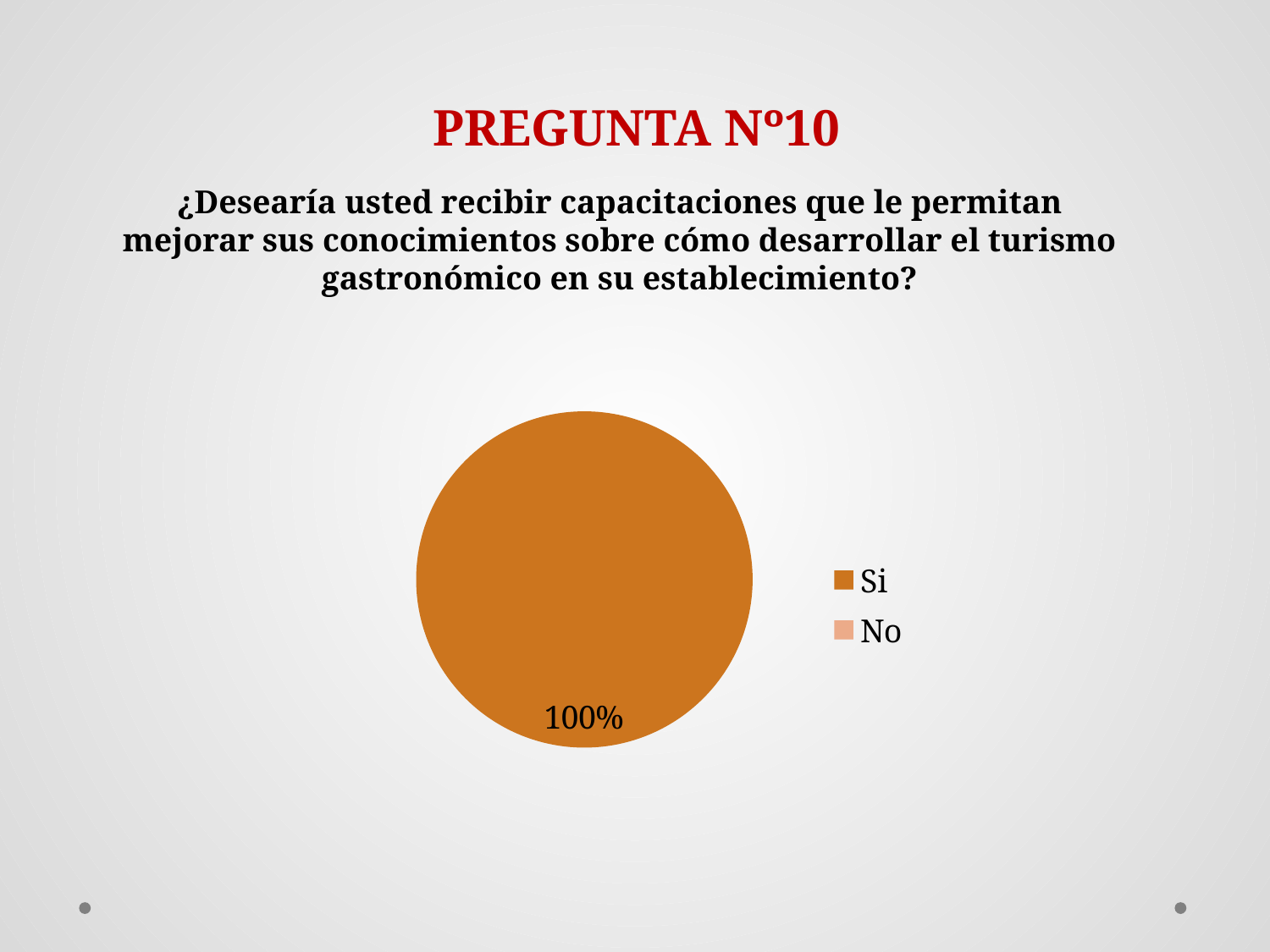
Is the share for "Si" greater or less than 50%? greater What are the two legend entries of the pie chart? Si and No What colour is the "Si" slice of the pie chart? orange What share of the pie does the "Si" slice represent? 100% Which category has the largest share of the pie? Si How many entries does the legend list? 2 What is the only data label printed on the pie chart? 100% What kind of chart is shown on the slide? pie chart Which of the two categories, Si or No, has the larger share? Si